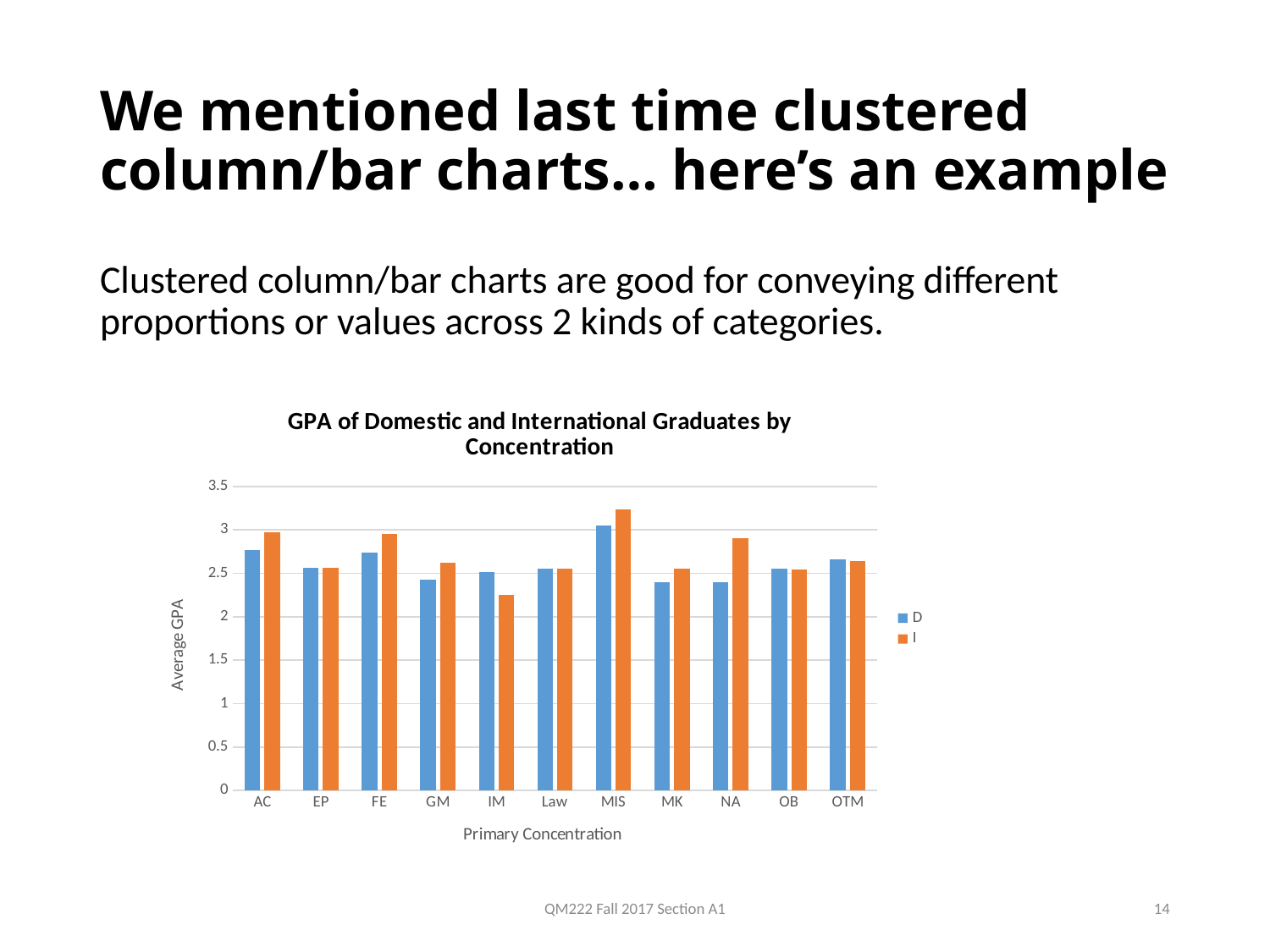
Is the I value for MIS greater or less than 3? greater What is the title of the chart? GPA of Domestic and International Graduates by Concentration What kind of chart is shown on the slide? bar chart How many series does the chart's legend list? 2 Which concentration has the highest average GPA for the I series? MIS Is the I value for NA greater or less than 2.5? greater Which concentration has the lowest average GPA for the I series? IM For AC, which series has the larger average GPA, D or I? I Which concentration has the highest average GPA for the D series? MIS For IM, which series has the larger average GPA, D or I? D Is the I value for IM greater or less than 2.5? less How many concentrations are shown on the x axis of the chart? 11